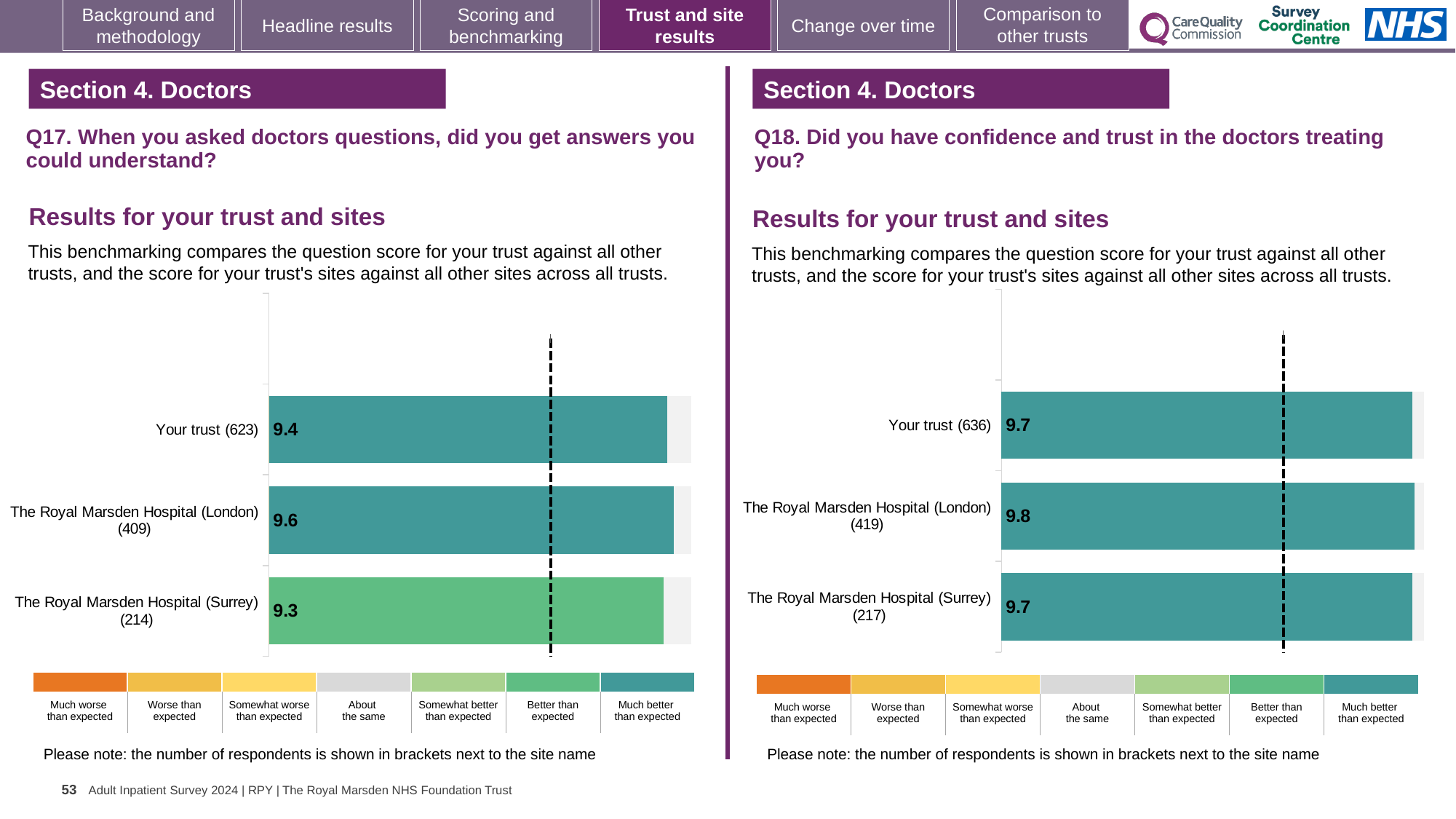
What kind of chart is the Q18 chart (right)? Bar chart On the Q18 chart (right), what is the difference between the scores for The Royal Marsden Hospital (London) and Your trust? 0.1 On the Q17 chart (left), which benchmark category does the colour of the bar for The Royal Marsden Hospital (Surrey) correspond to in the legend? Better than expected On the Q17 chart (left), what is the score for The Royal Marsden Hospital (Surrey) (214)? 9.3 On the Q17 chart (left), what is the difference between the scores for The Royal Marsden Hospital (London) and The Royal Marsden Hospital (Surrey)? 0.3 On the Q17 chart (left), how many bars are plotted? 3 On the Q17 chart (left), which site or trust has the highest score? The Royal Marsden Hospital (London) (409) On the Q18 chart (right), what is the score for The Royal Marsden Hospital (London) (419)? 9.8 On the Q18 chart (right), which site or trust has the highest score? The Royal Marsden Hospital (London) (419) On the Q17 chart (left), which site or trust has the lowest score? The Royal Marsden Hospital (Surrey) (214) On the Q17 chart (left), what is the score for Your trust (623)? 9.4 On the Q18 chart (right), what is the score for Your trust (636)? 9.7